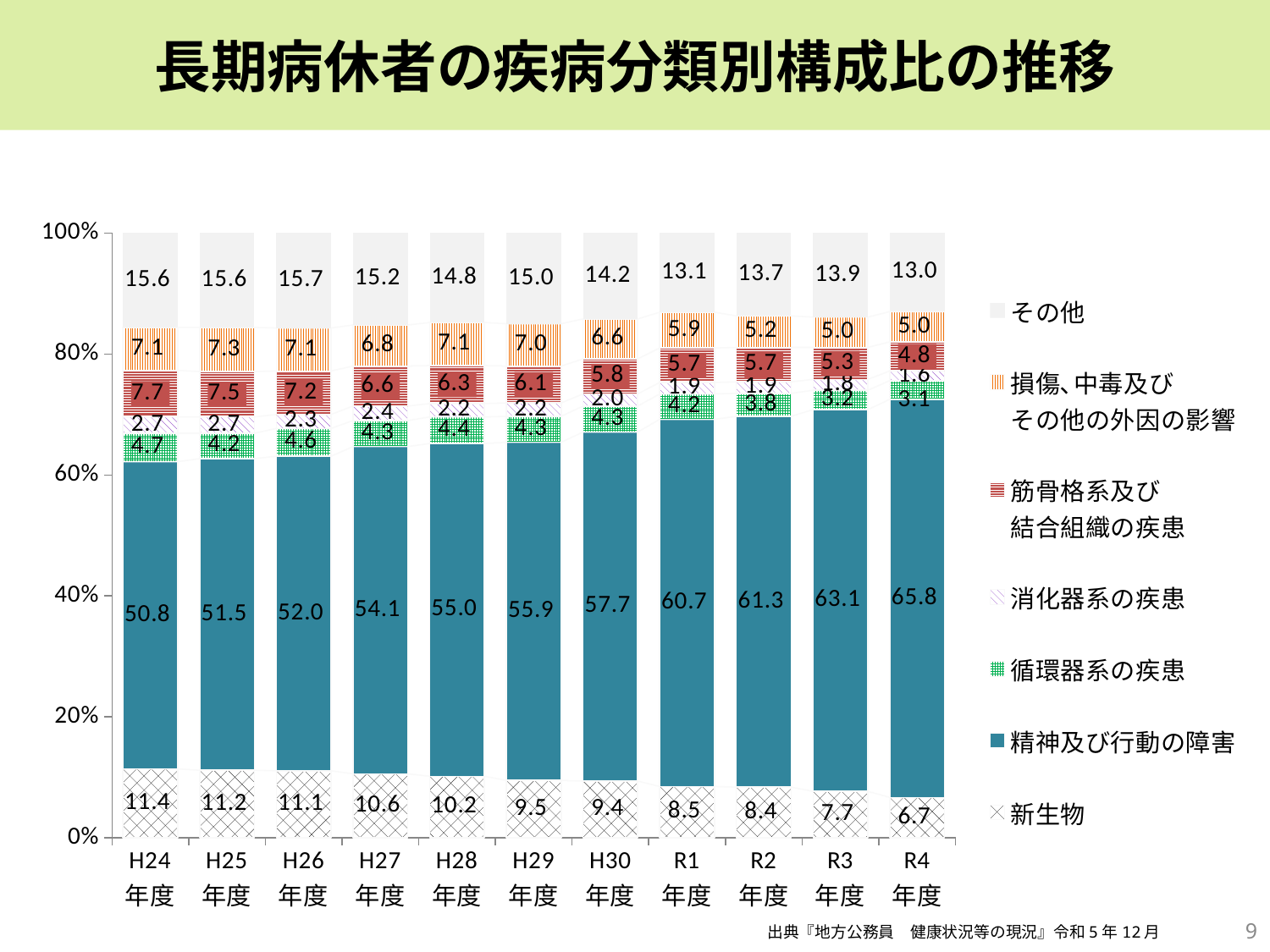
Which year has the lowest value for 新生物? R4年度 What is the value for 新生物 in H24年度? 11.4 What is the value for 精神及び行動の障害 in R4年度? 65.8 Does the value for 新生物 rise or fall from H24年度 to R4年度? Fall What is the value for その他 in H30年度? 14.2 What is the difference between the 精神及び行動の障害 values in R4年度 and H24年度? 15.0 How many years (categories) are shown on the x axis? 11 Which is larger, the その他 value in H26年度 or in R1年度? H26年度 Which year has the highest value for 精神及び行動の障害? R4年度 What is the title of the chart? 長期病休者の疾病分類別構成比の推移 How many series does the legend list? 7 What kind of chart is shown on the slide? Stacked bar chart